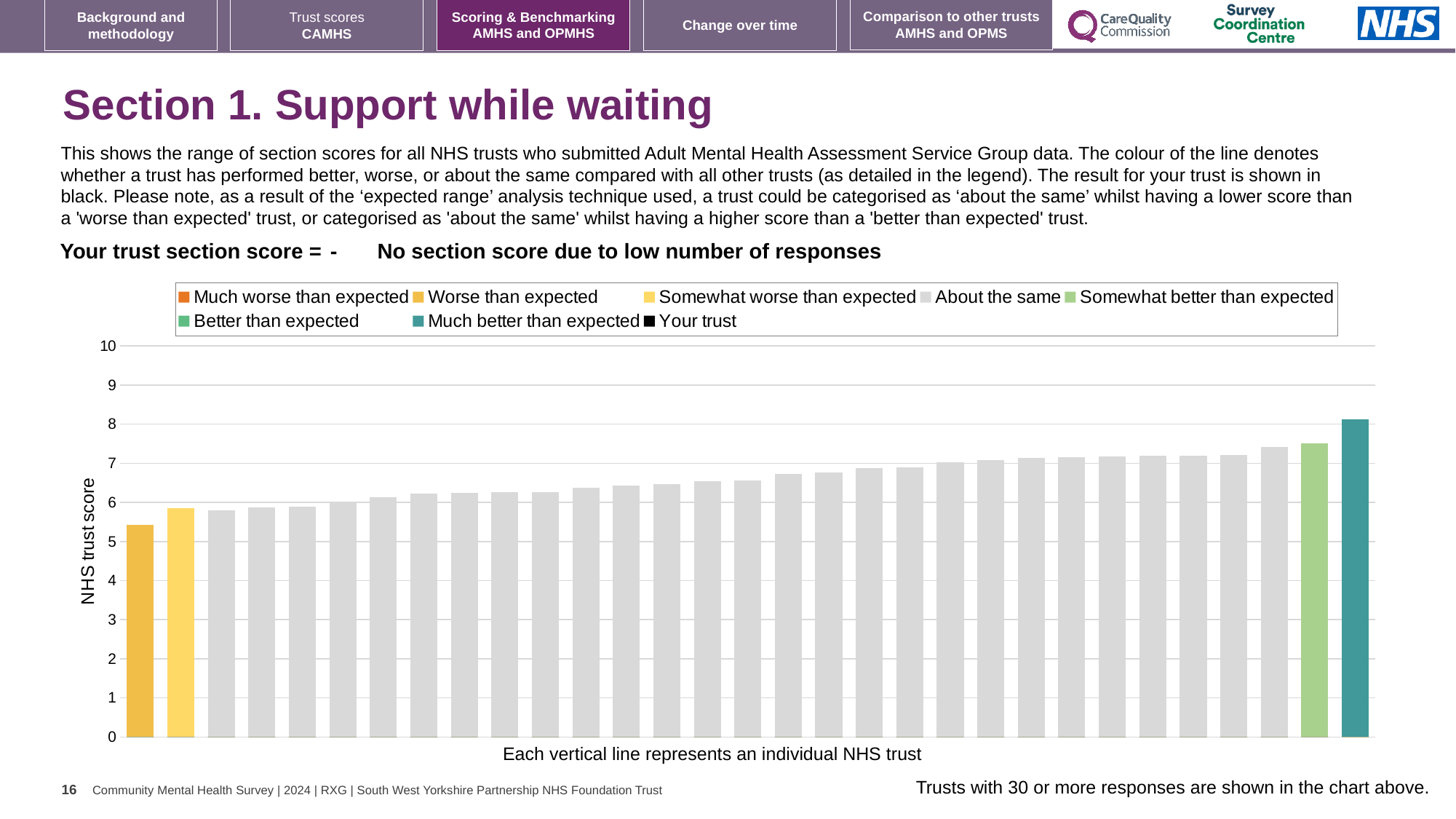
How many bars (NHS trusts) are plotted in the chart? 31 Which is taller: the leftmost bar or the rightmost bar? the rightmost bar What kind of chart is shown on the slide? bar chart Is the value of the shortest bar greater or less than 6? less Is the value of the tallest bar greater or less than 7? greater Which legend category does the tallest bar in the chart belong to? Much better than expected Is the value of the second bar from the left greater or less than 7? less What is the highest value shown on the vertical axis? 10 Which legend category does the shortest bar in the chart belong to? Worse than expected Do the bar values rise or fall from left to right across the chart? rise How many entries does the chart legend list? 8 What is the label on the vertical axis of the chart? NHS trust score